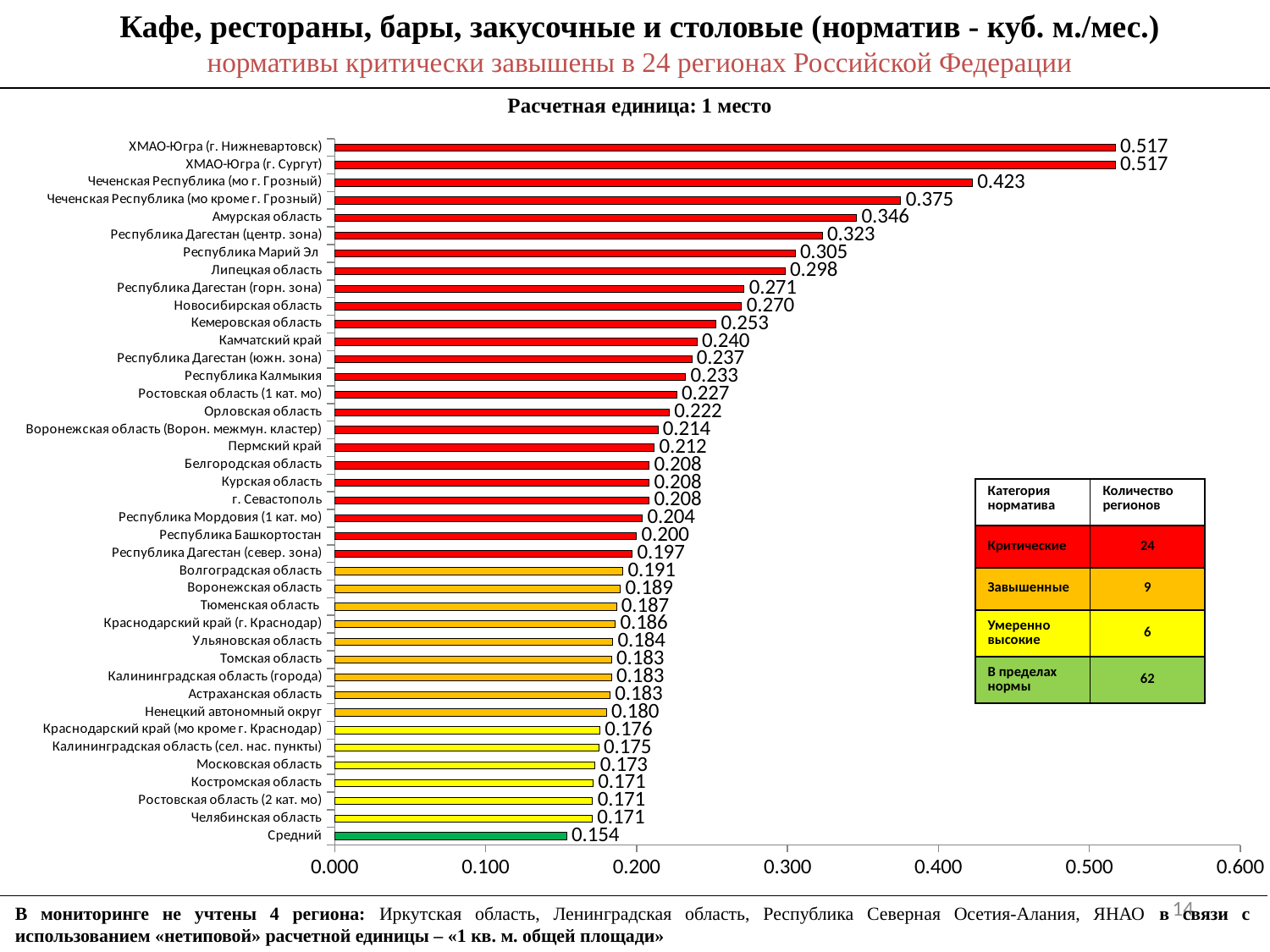
Which has a larger value, Липецкая область or Кемеровская область? Липецкая область How many bars are plotted on the chart? 40 Which category has the lowest value on the chart? Средний What is the difference between the values for Чеченская Республика (мо г. Грозный) and Чеченская Республика (мо кроме г. Грозный)? 0.048 What is the value for Московская область? 0.173 What type of chart is shown on the slide? Bar chart Is the value for Республика Дагестан (центр. зона) greater or less than 0.300? greater What is the value for Республика Марий Эл? 0.305 According to the table on the slide, how many regions fall into the Критические category? 24 What is the value of the Средний bar? 0.154 What is the difference between the values for ХМАО-Югра (г. Сургут) and Средний? 0.363 What is the value for Амурская область? 0.346